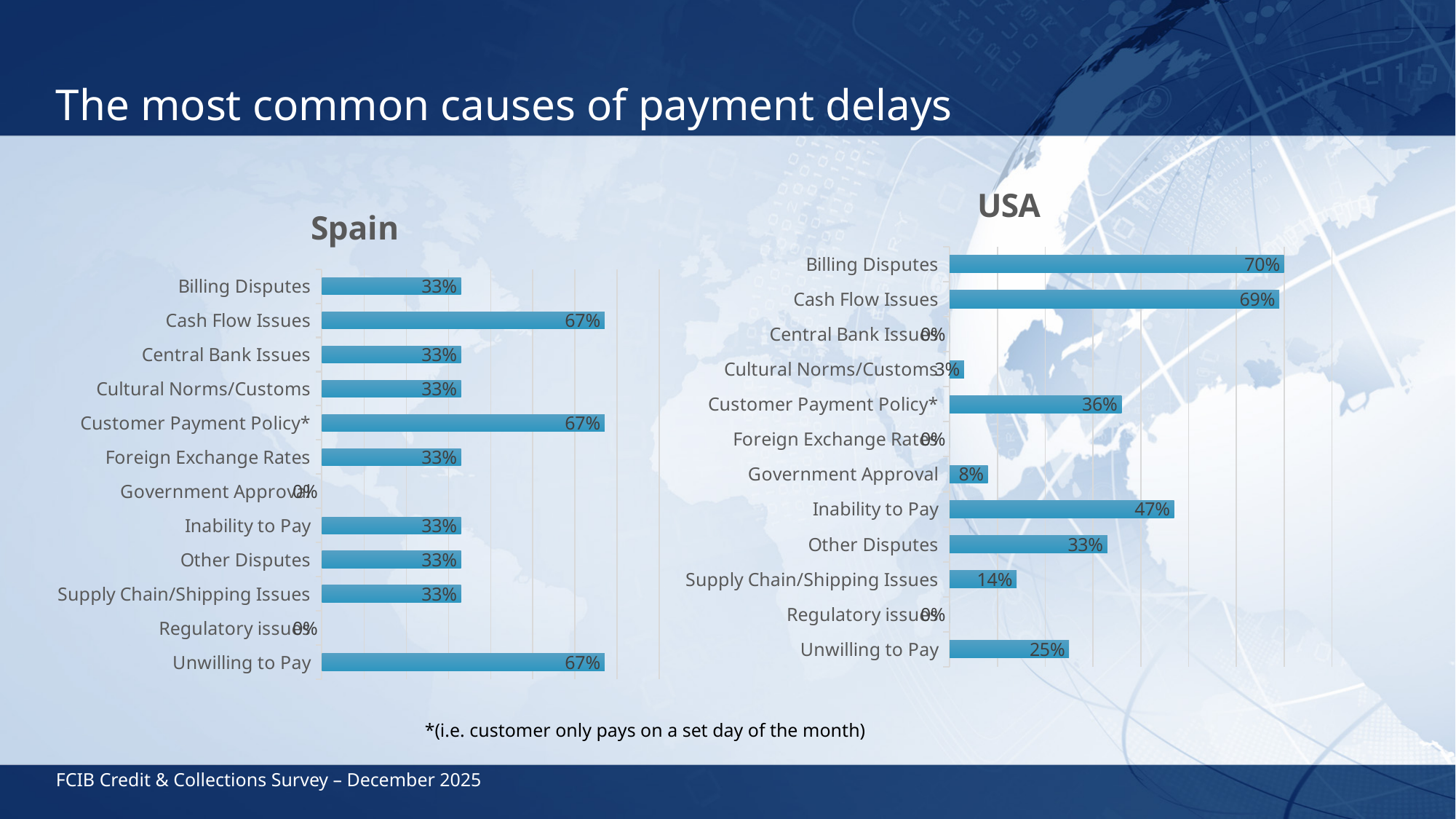
What is the title of the chart on the right side of the slide? USA How many causes are listed in the USA chart? 12 In the USA chart, which is larger: Customer Payment Policy* or Other Disputes? Customer Payment Policy* In the USA chart, what is the difference between Billing Disputes and Unwilling to Pay? 45% In the Spain chart, what is the difference between Unwilling to Pay and Billing Disputes? 34% In the Spain chart, which is larger: Customer Payment Policy* or Foreign Exchange Rates? Customer Payment Policy* In the USA chart, which cause has the highest value? Billing Disputes In the USA chart, what is the value for Supply Chain/Shipping Issues? 14% In the Spain chart, what is the value for Cash Flow Issues? 67% In the USA chart, what is the value for Inability to Pay? 47% What type of chart is the Spain chart? Bar chart In the Spain chart, what is the value for Government Approval? 0%